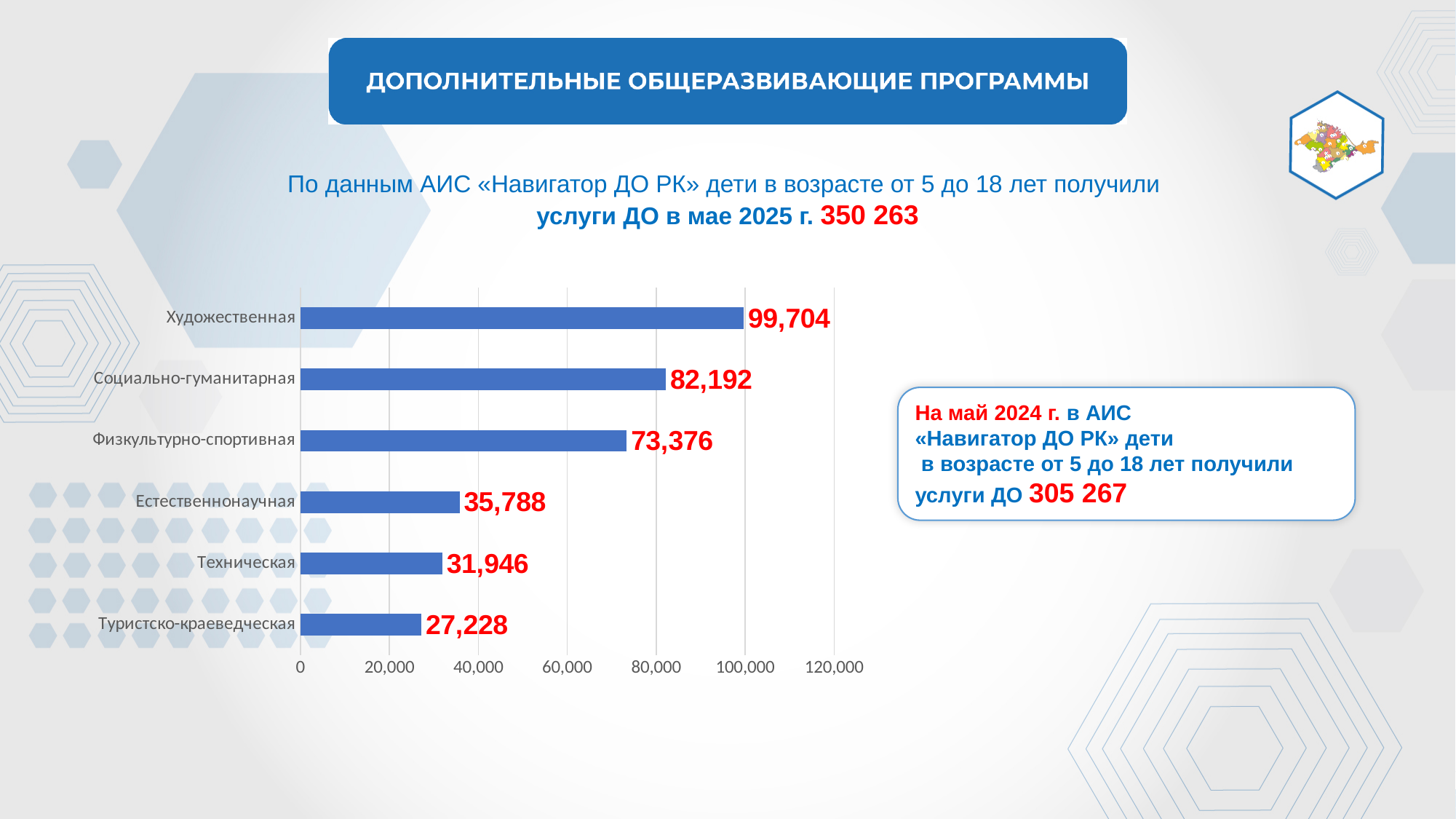
How many categories are shown in the chart? 6 Which category has the lowest value? Туристско-краеведческая What is the highest tick value shown on the horizontal axis? 120,000 Is the value for Естественнонаучная greater or less than 40,000? less What kind of chart is shown on the slide? bar chart What is the value for Туристско-краеведческая? 27,228 What is the value for Физкультурно-спортивная? 73,376 Which is larger, the value for Социально-гуманитарная or the value for Физкультурно-спортивная? Социально-гуманитарная What is the value for Художественная? 99,704 What is the difference between the values for Художественная and Социально-гуманитарная? 17,512 Which category has the highest value? Художественная What is the difference between the values for Естественнонаучная and Техническая? 3,842